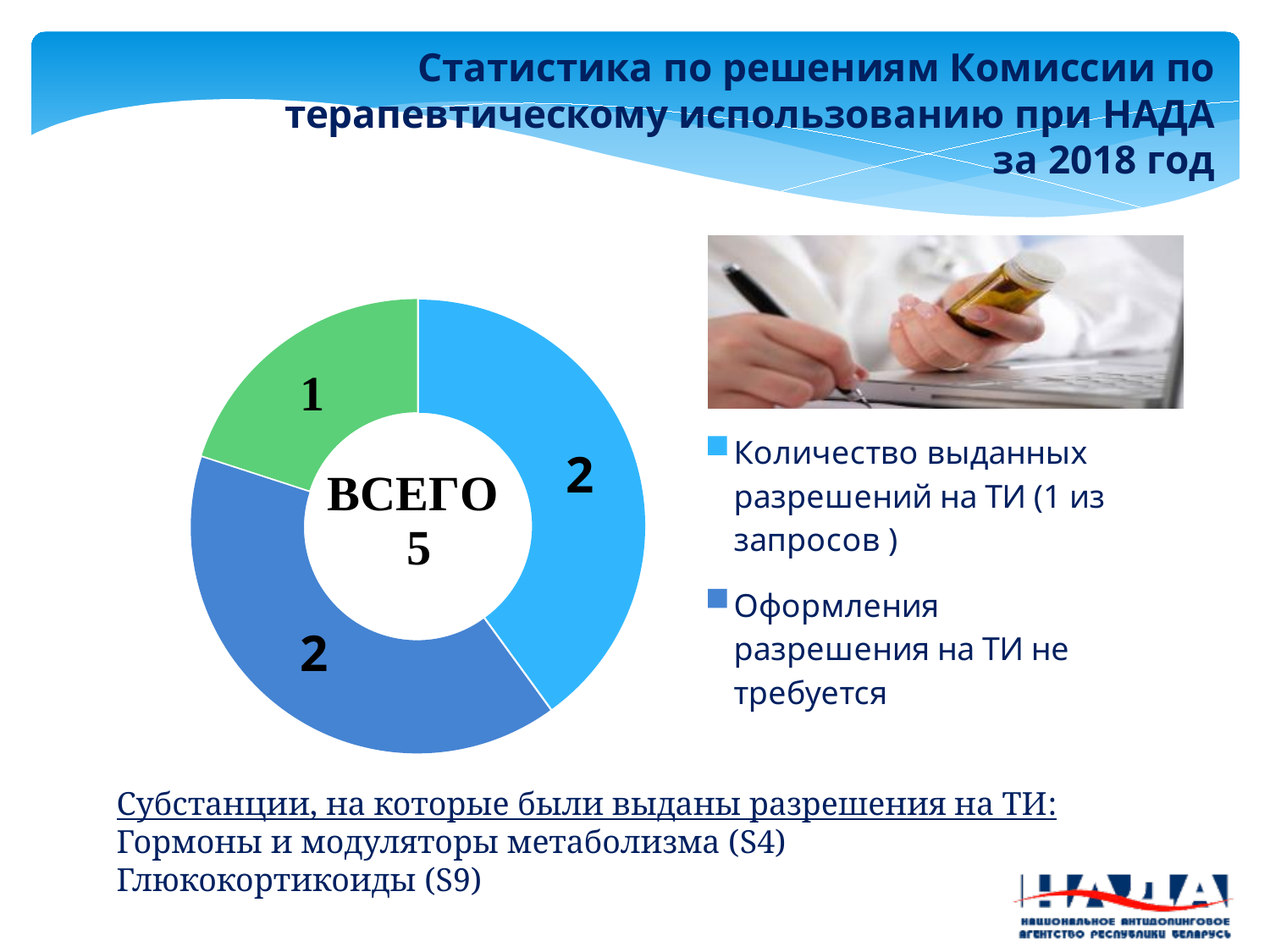
Is the value of the green slice larger or smaller than the value of the light blue "Количество выданных разрешений на ТИ" slice? Smaller What is the value of the slice labelled "Оформления разрешения на ТИ не требуется" (dark blue)? 2 What share of the total does the green slice (value 1) represent? 20% Which slice of the doughnut chart has the smallest value? The green slice (1) What is the value of the slice labelled "Количество выданных разрешений на ТИ" (light blue)? 2 What is the title of the slide containing the chart? Статистика по решениям Комиссии по терапевтическому использованию при НАДА за 2018 год How many slices does the doughnut chart have? 3 What total is printed in the centre of the doughnut chart? ВСЕГО 5 What share of the total does the "Количество выданных разрешений на ТИ" slice represent? 40% How many entries does the legend next to the chart list? 2 What kind of chart is shown on the slide? Doughnut (pie) chart What is the value of the green slice of the doughnut chart? 1